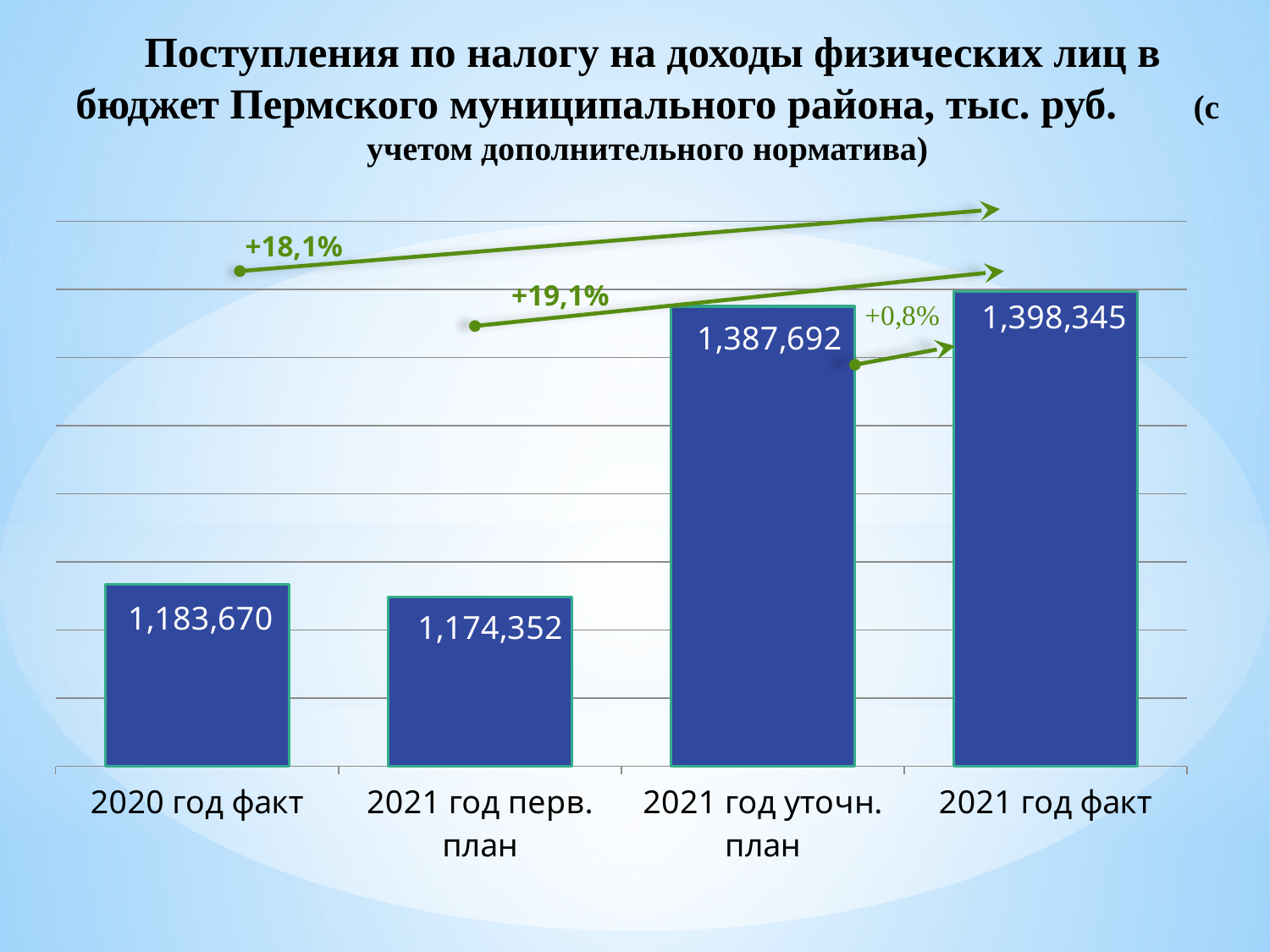
What is the value for 2020 год факт? 1,183,670 What is the value for 2021 год факт? 1,398,345 How many categories are shown on the x axis? 4 Which category has the highest value? 2021 год факт Which category has the lowest value? 2021 год перв. план What is the value for 2021 год уточн. план? 1,387,692 What is the difference between the values for 2020 год факт and 2021 год перв. план? 9,318 What percentage change is annotated between 2021 год уточн. план and 2021 год факт? +0,8% What kind of chart is shown on the slide? Bar chart What is the value for 2021 год перв. план? 1,174,352 What is the difference between the values for 2021 год факт and 2021 год уточн. план? 10,653 Which is larger, the value for 2020 год факт or the value for 2021 год перв. план? 2020 год факт